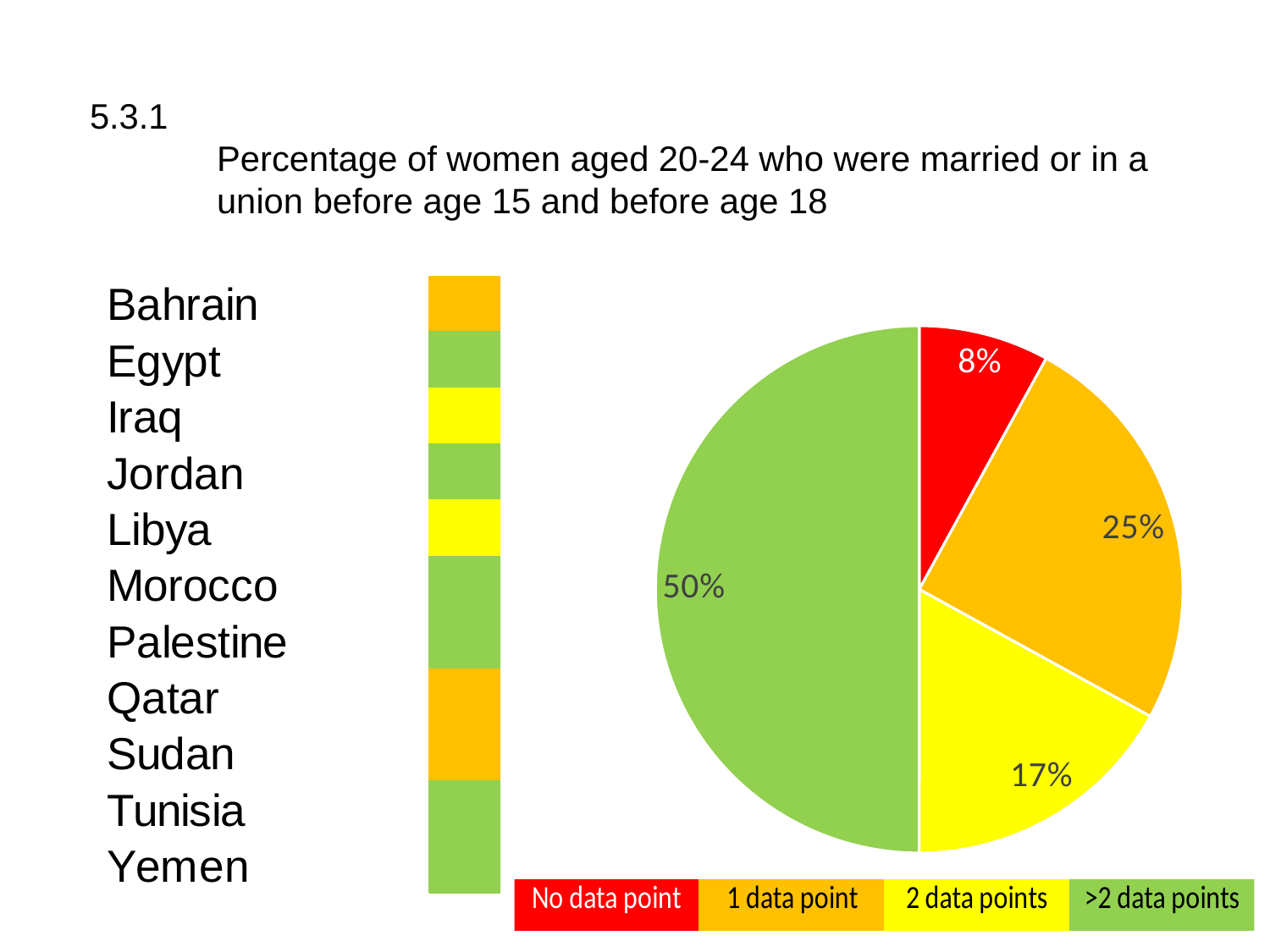
How many slices does the pie chart have? 4 Which category has the largest slice of the pie? >2 data points Which slice is larger, '1 data point' or 'No data point'? 1 data point What share of the pie is labelled '2 data points'? 17% What share of the pie is labelled '>2 data points'? 50% What share of the pie is labelled 'No data point'? 8% What colour is the 'No data point' slice in the pie chart? red What kind of chart is shown on the slide? pie chart How many entries does the legend list? 4 Which category has the smallest slice of the pie? No data point What is the difference in percentage points between the '1 data point' slice and the '2 data points' slice? 8